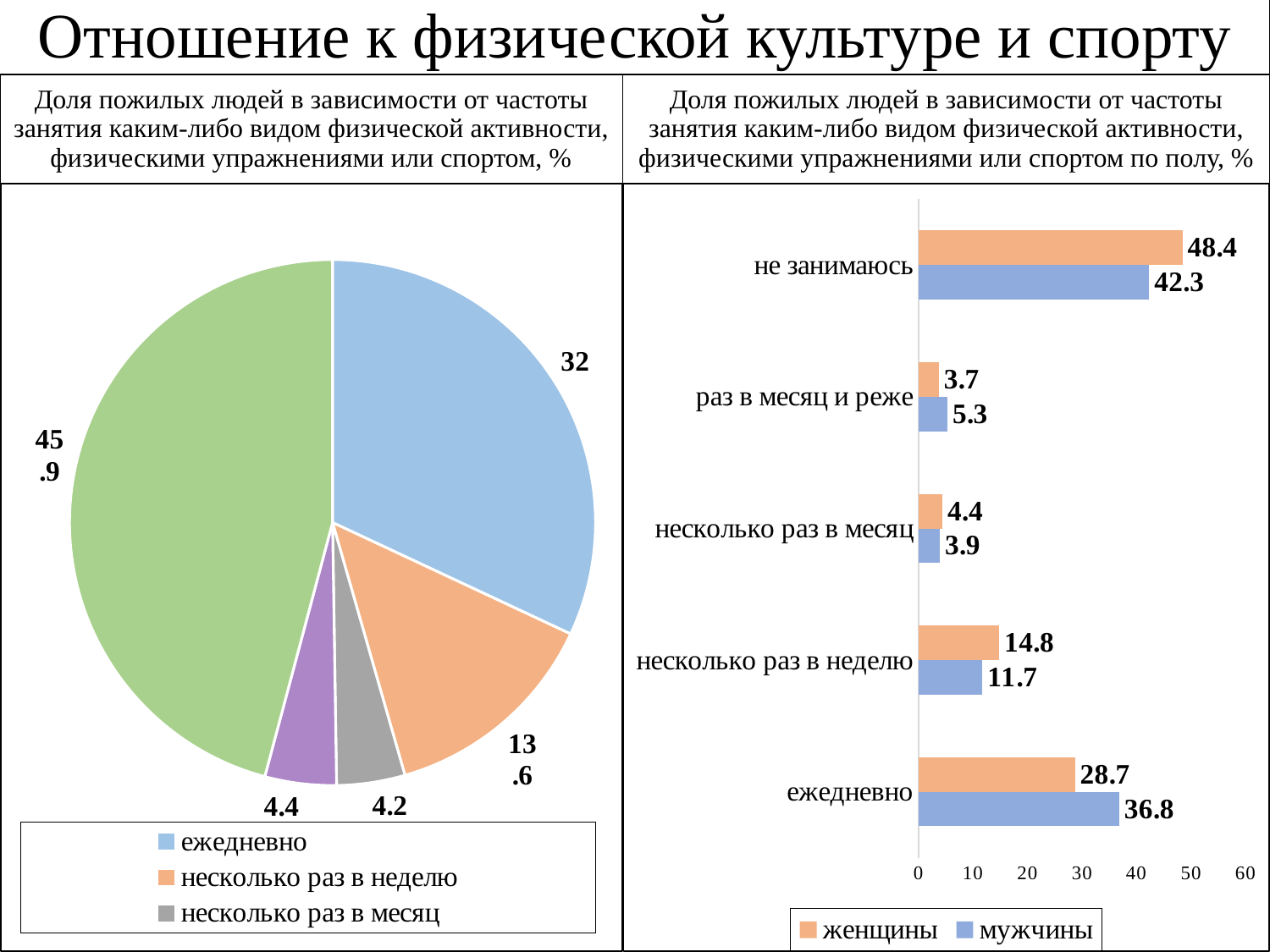
In the bar chart on the right, which series has the larger value for ежедневно, женщины or мужчины? мужчины What kind of chart is the chart on the right side of the slide? bar chart In the pie chart on the left, what is the value for несколько раз в неделю? 13.6 How many categories are shown in the bar chart on the right? 5 In the bar chart on the right, which category has the lowest value for женщины? раз в месяц и реже In the pie chart on the left, what is the value for несколько раз в месяц? 4.2 In the bar chart on the right, what is the value for мужчины in the category ежедневно? 36.8 What kind of chart is the chart on the left side of the slide? pie chart In the bar chart on the right, what is the value for женщины in the category не занимаюсь? 48.4 How many series does the legend of the bar chart on the right list? 2 In the pie chart on the left, what is the value for ежедневно? 32 In the bar chart on the right, what is the difference between женщины and мужчины in the category не занимаюсь? 6.1